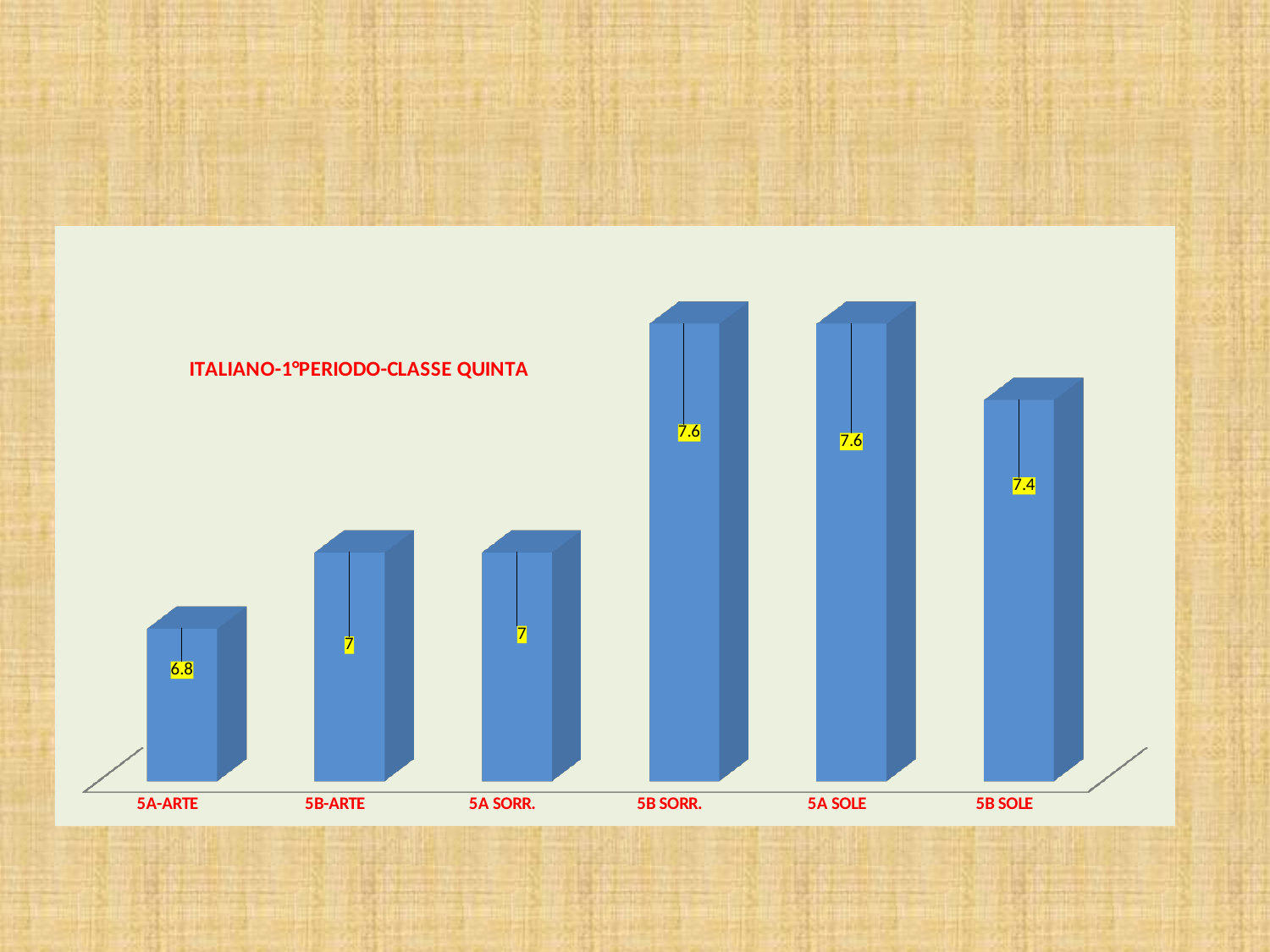
What is the value for 5B-ARTE? 7 What is the value for 5A-ARTE? 6.8 Which category has the lowest value? 5A-ARTE What is the value for 5B SORR.? 7.6 What is the difference between the values for 5B SOLE and 5A SORR.? 0.4 How many categories are shown on the chart? 6 What is the title of the chart? ITALIANO-1°PERIODO-CLASSE QUINTA Do the values for 5A-ARTE, 5B-ARTE and 5A SORR. have the same value as 5B SORR.? No What is the difference between the values for 5B SORR. and 5A-ARTE? 0.8 What is the value for 5B SOLE? 7.4 What kind of chart is shown on the slide? bar chart Which is larger, the value for 5A SOLE or the value for 5B SOLE? 5A SOLE